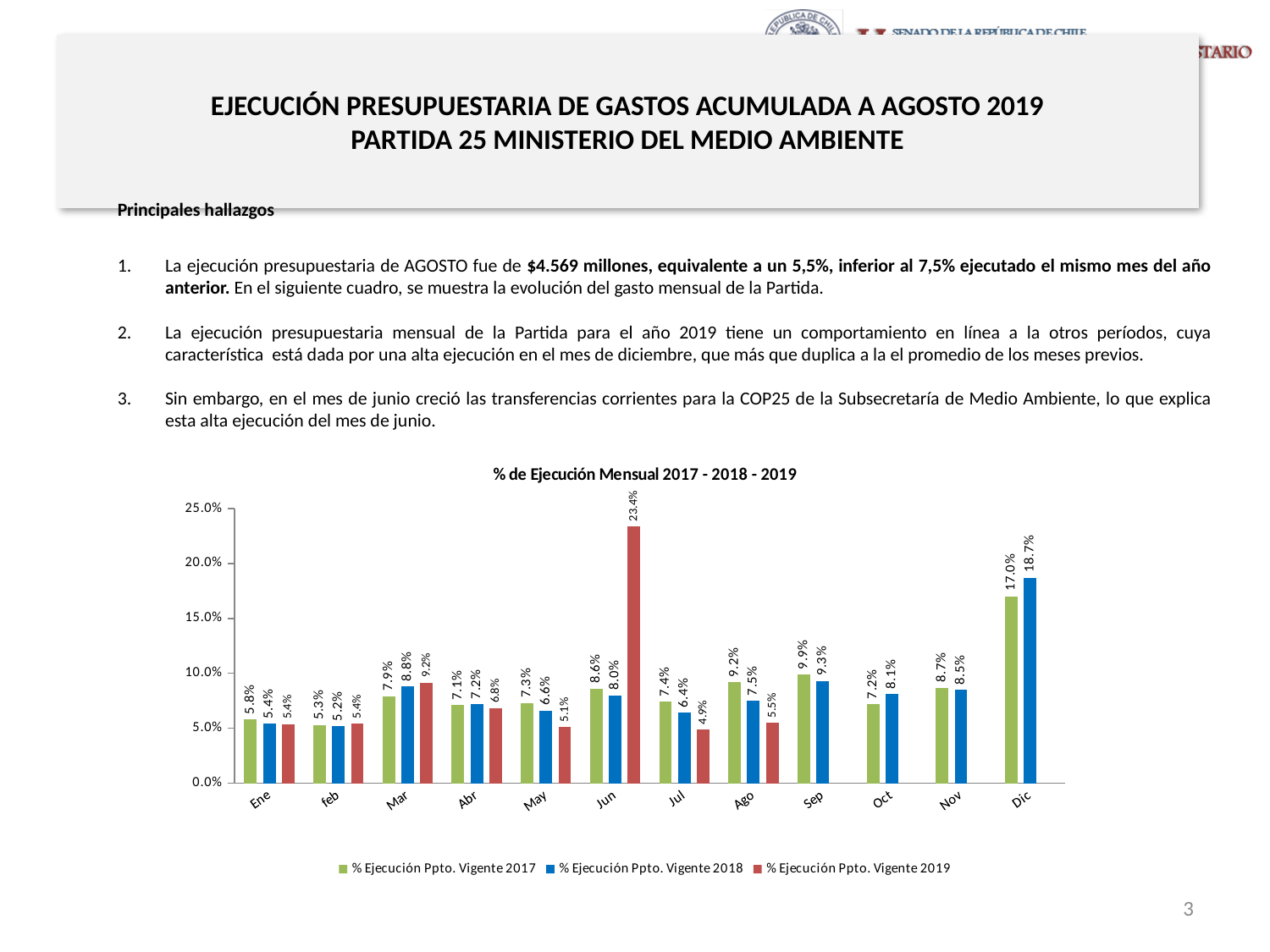
What is the value for Dic in the % Ejecución Ppto. Vigente 2018 series? 18.7% What is the difference between the 2018 and 2017 values for Dic? 1.7% What is the value for Ago in the % Ejecución Ppto. Vigente 2017 series? 9.2% Which is larger for Mar: the 2017 value or the 2019 value? 2019 value Is the value for Jun in the 2019 series greater or less than 20.0%? greater What kind of chart is shown on the slide? Bar chart How many months are shown on the x axis? 12 What is the title of the chart? % de Ejecución Mensual 2017 - 2018 - 2019 How many series does the legend list? 3 Which month has the lowest value in the % Ejecución Ppto. Vigente 2019 series? Jul What is the value for Jun in the % Ejecución Ppto. Vigente 2019 series? 23.4% Which month has the highest value in the % Ejecución Ppto. Vigente 2019 series? Jun